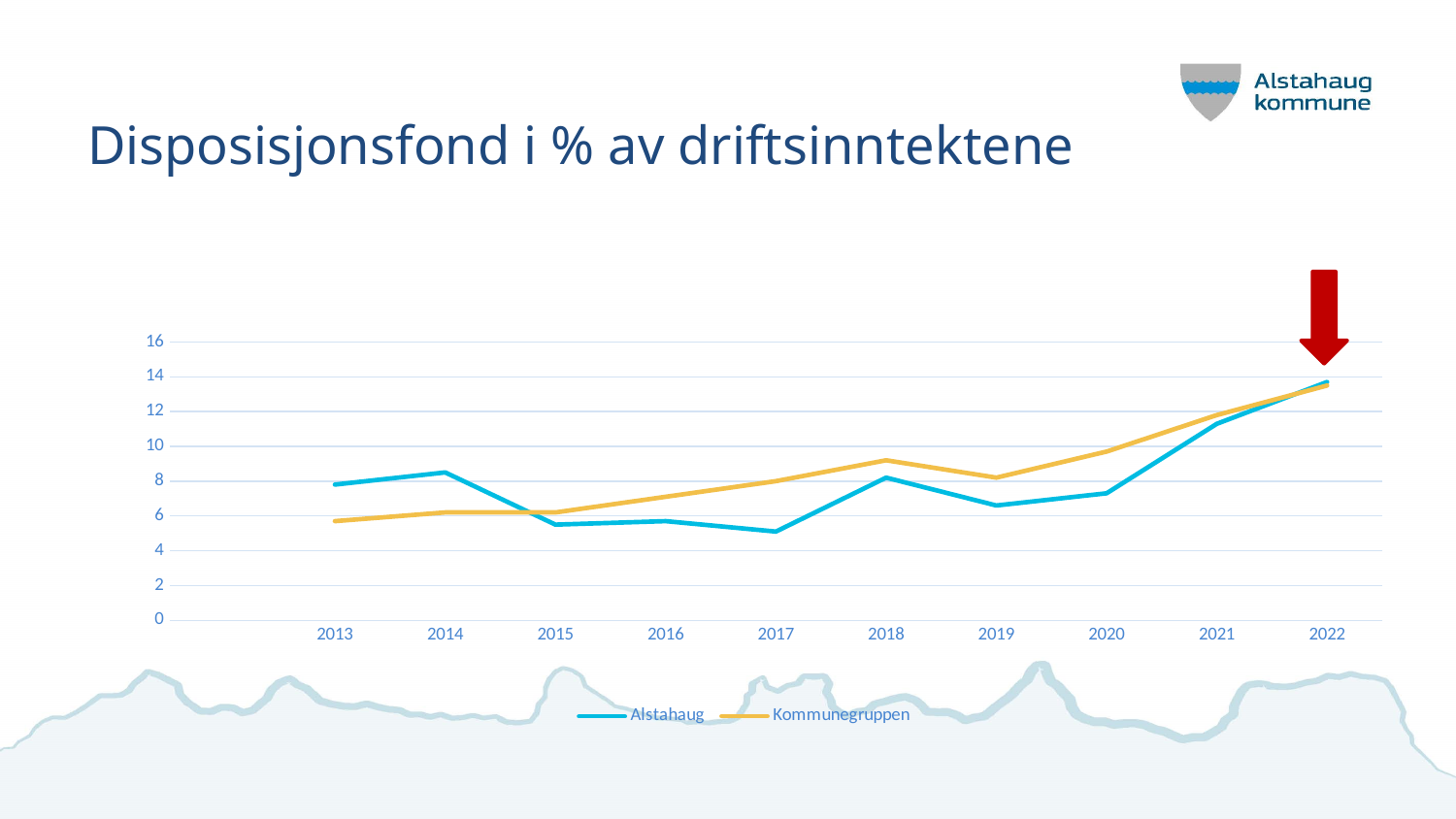
Does the Kommunegruppen series rise or fall from 2019 to 2022? rise How many series does the legend list? 2 In which year does the Alstahaug series reach its lowest value? 2017 What is the title of the chart on the slide? Disposisjonsfond i % av driftsinntektene What kind of chart is shown on the slide? Line chart In 2014, which series has the higher value, Alstahaug or Kommunegruppen? Alstahaug In 2018, which series has the higher value, Alstahaug or Kommunegruppen? Kommunegruppen Is the value for Kommunegruppen in 2013 greater or less than 6? less How many years are plotted along the x axis? 10 In which year does the Kommunegruppen series have its lowest value? 2013 In which year does the Alstahaug series reach its highest value? 2022 Is the value for Alstahaug in 2021 greater or less than 10? greater